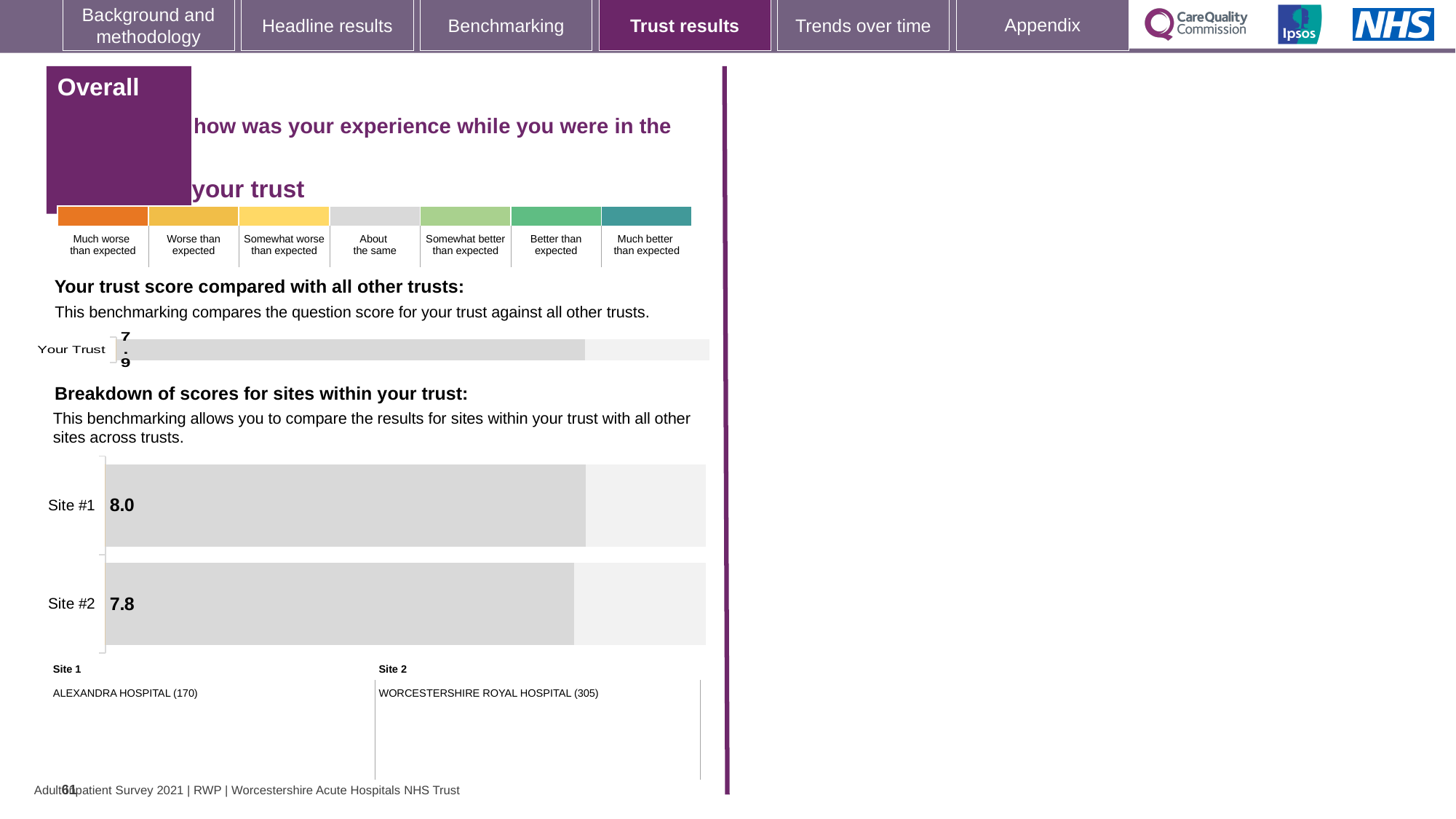
In the 'Breakdown of scores for sites within your trust' chart, which site has the lowest score? Site #2 In the 'Breakdown of scores for sites within your trust' chart, what is the score for Site #1? 8.0 How many sites are shown in the 'Breakdown of scores for sites within your trust' chart? 2 In the 'Your trust score compared with all other trusts' chart, what is the score for Your Trust? 7.9 In the 'Breakdown of scores for sites within your trust' chart, which site has the highest score? Site #1 In the 'Breakdown of scores for sites within your trust' chart, what is the difference between the scores for Site #1 and Site #2? 0.2 How many categories are plotted in the 'Your trust score compared with all other trusts' chart? 1 According to the site key below the 'Breakdown of scores for sites within your trust' chart, which hospital is Site 1? ALEXANDRA HOSPITAL (170) What kind of chart is the 'Breakdown of scores for sites within your trust' chart? bar chart In the 'Breakdown of scores for sites within your trust' chart, what is the score for Site #2? 7.8 In the 'Breakdown of scores for sites within your trust' chart, is the score for Site #1 larger or smaller than the score for Site #2? larger According to the site key below the 'Breakdown of scores for sites within your trust' chart, which hospital is Site 2? WORCESTERSHIRE ROYAL HOSPITAL (305)